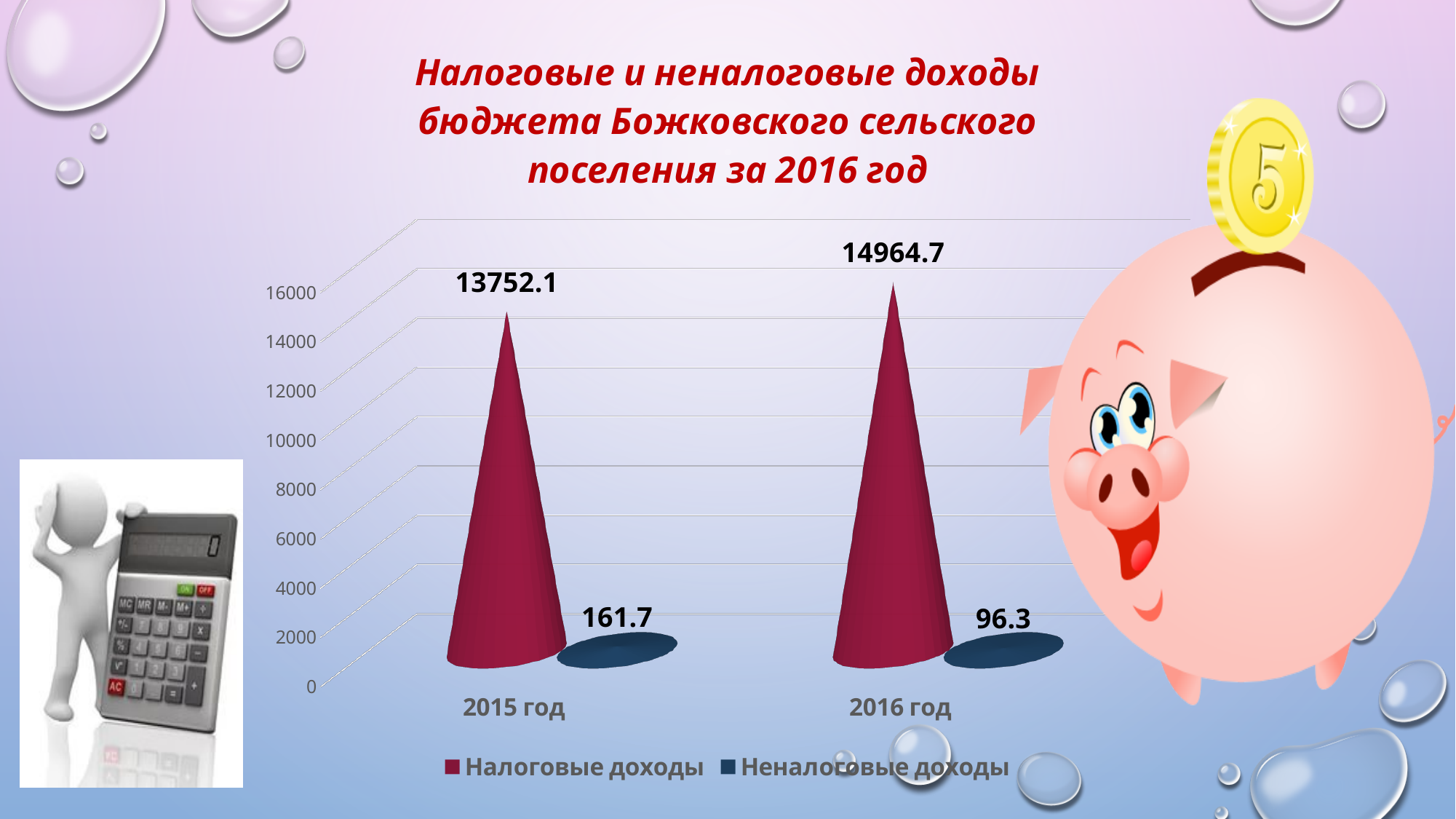
Which year has the higher value for Налоговые доходы? 2016 год What is the value of Налоговые доходы for 2015 год? 13752.1 What is the value of Налоговые доходы for 2016 год? 14964.7 Is the value for Налоговые доходы in 2015 год greater or less than 12000? greater What is the value of Неналоговые доходы for 2015 год? 161.7 What is the value of Неналоговые доходы for 2016 год? 96.3 By how much did Налоговые доходы increase from 2015 год to 2016 год? 1212.6 What is the difference between Неналоговые доходы in 2015 год and 2016 год? 65.4 Do the values for Налоговые доходы rise or fall from 2015 год to 2016 год? rise Which year has the lower value for Неналоговые доходы? 2016 год How many categories are shown on the x axis? 2 How many series does the legend list? 2